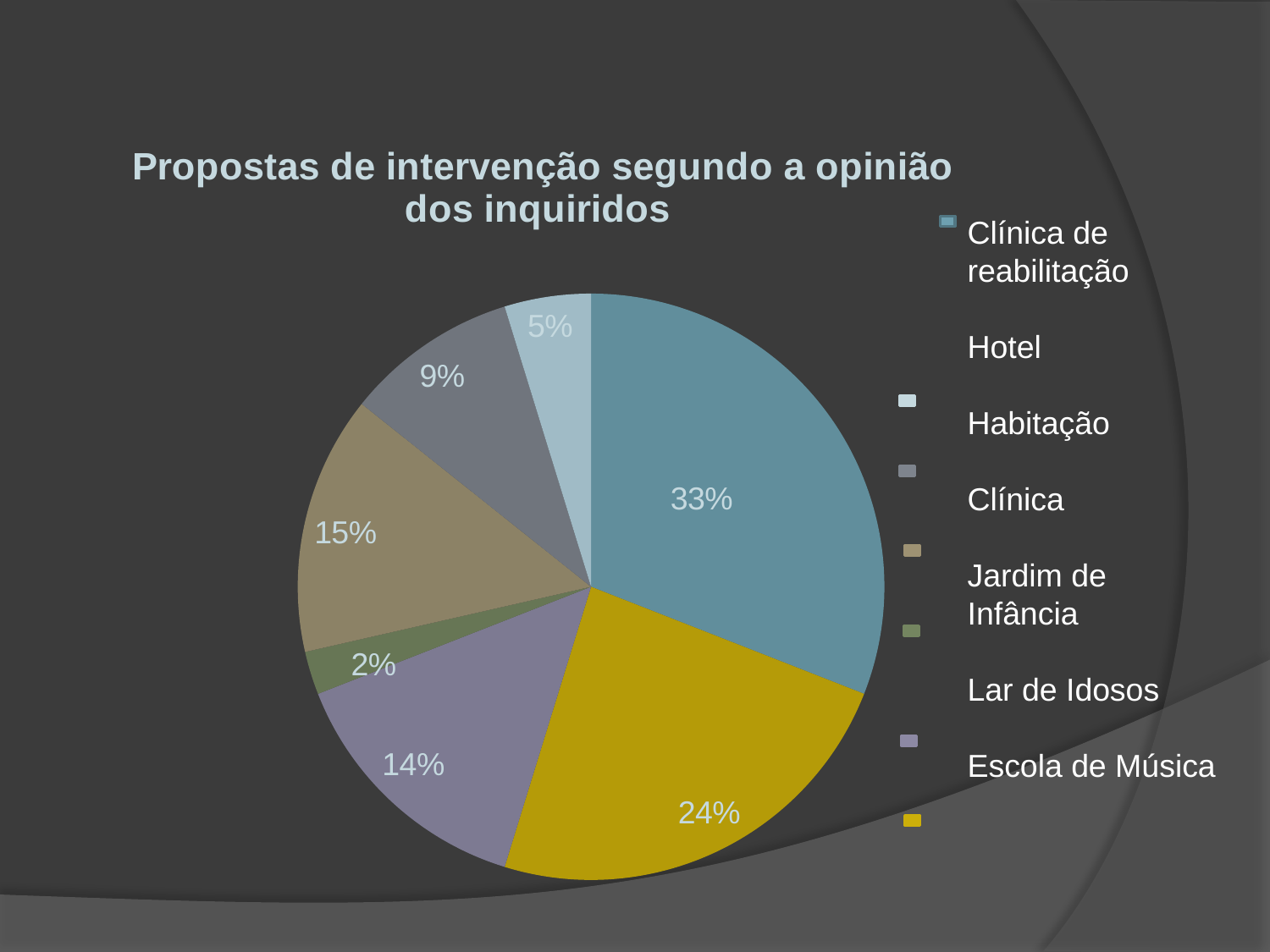
What percentage is shown for Hotel? 5% What percentage is shown for Habitação? 9% What percentage is shown for Clínica? 15% Which is larger, the share for Clínica or the share for Lar de Idosos? Clínica How many slices does the pie chart have? 7 Which category has the largest share of the pie? Clínica de reabilitação What kind of chart is shown on the slide? pie chart What is the title of the chart? Propostas de intervenção segundo a opinião dos inquiridos Which category has the smallest share of the pie? Jardim de Infância What percentage is shown for Lar de Idosos? 14% What percentage is shown for Escola de Música? 24% What is the difference in percentage points between the largest slice (33%) and the 24% slice? 9 percentage points